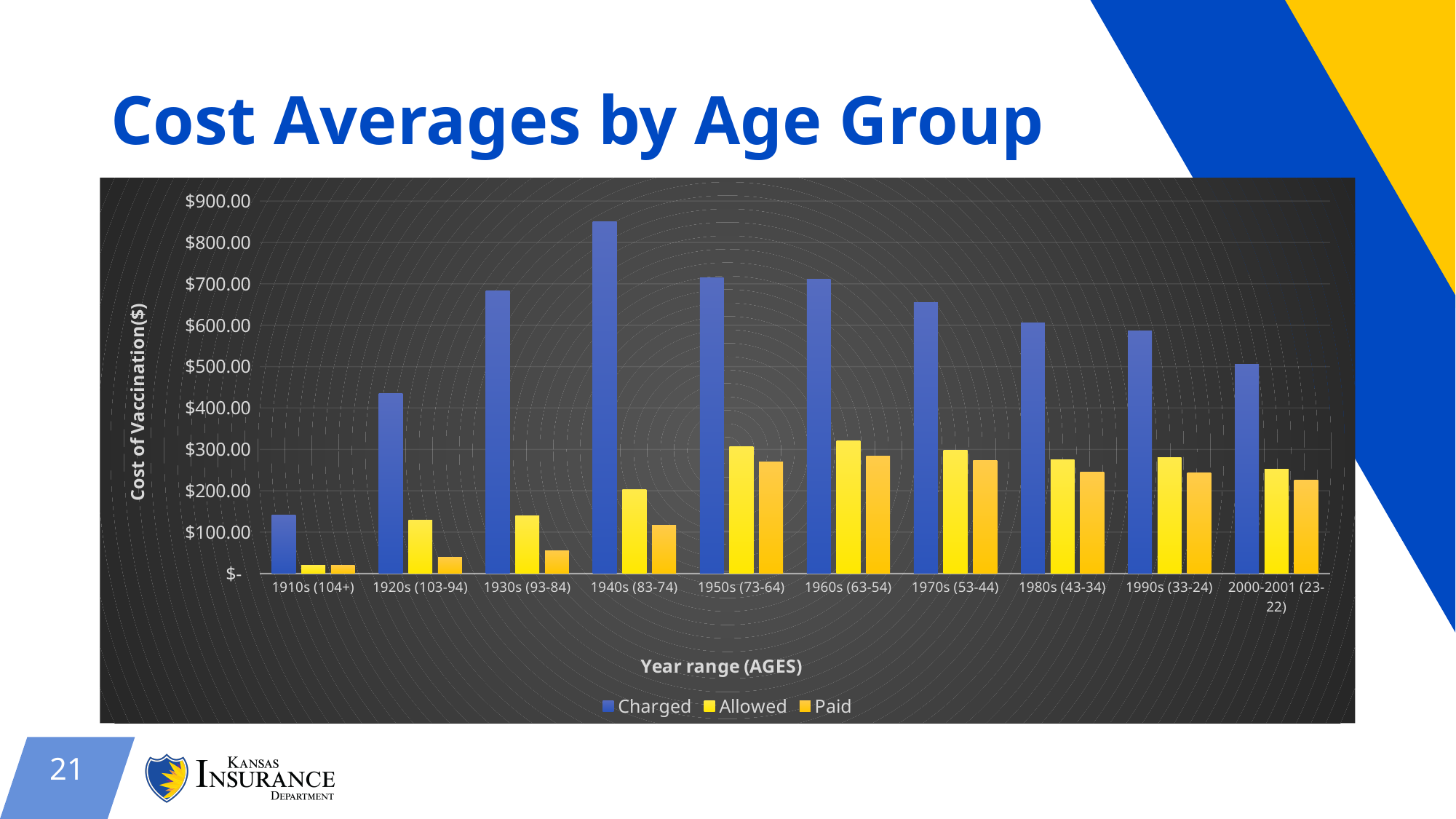
How many age-group categories are shown on the x axis? 10 Which age group has the lowest Charged value? 1910s (104+) What is the label of the y axis? Cost of Vaccination($) Which age group has the highest Charged value? 1940s (83-74) What kind of chart is shown on the slide? bar chart Do the Charged values rise or fall from 1940s (83-74) through 2000-2001 (23-22)? fall Is the Allowed value for 1910s (104+) greater or less than $100.00? less Is the Paid value for 1960s (63-54) greater or less than $200.00? greater How many series does the legend list? 3 Is the Charged value for 1920s (103-94) greater or less than $500.00? less Which is larger, the Charged value for 1970s (53-44) or for 1980s (43-34)? 1970s (53-44)